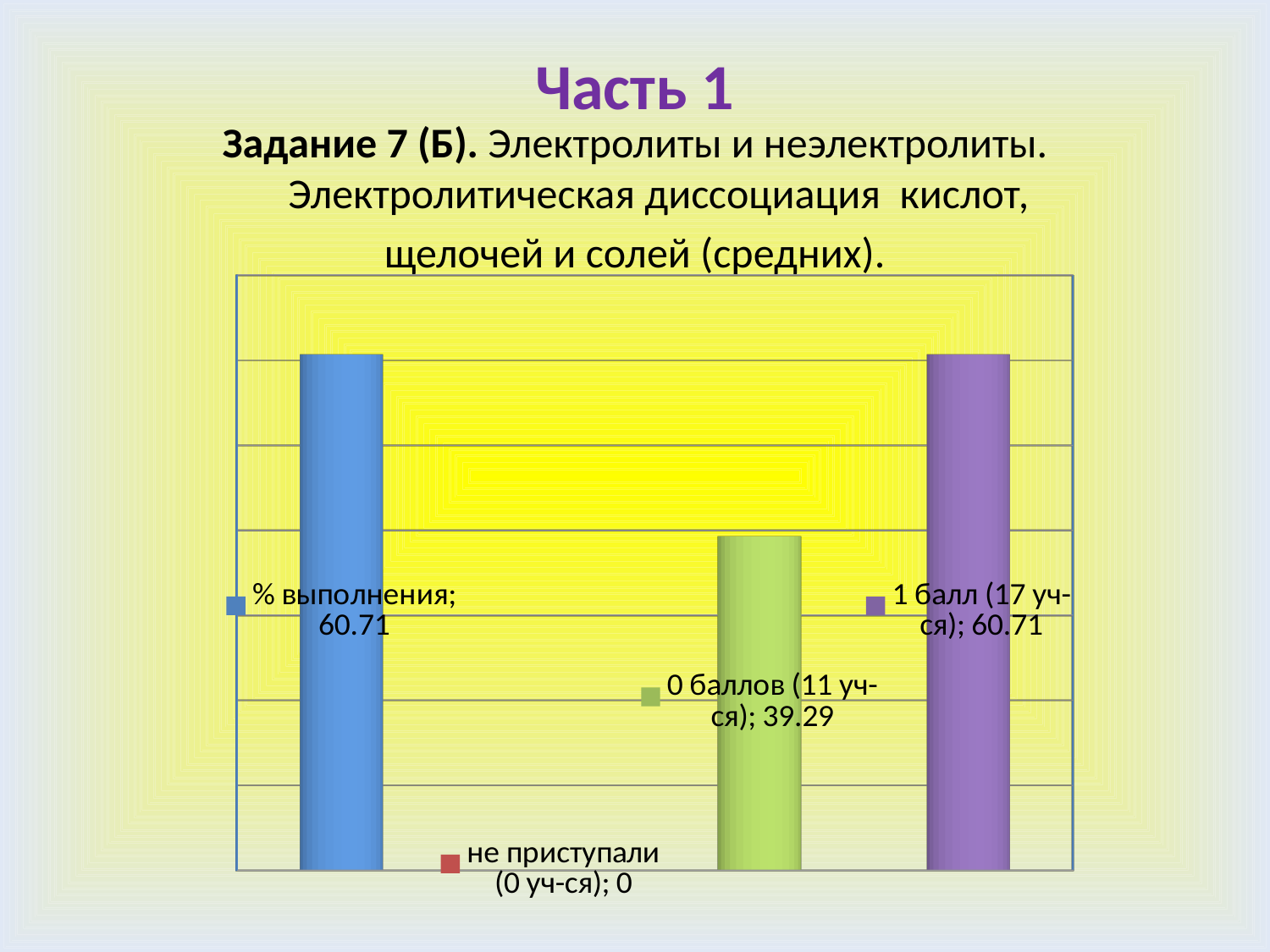
How many categories are plotted in the chart? 4 What is the value shown for "% выполнения"? 60.71 What is the value shown for "1 балл (17 уч-ся)"? 60.71 What is the value shown for "0 баллов (11 уч-ся)"? 39.29 How many students are indicated in the label for "0 баллов"? 11 What is the value shown for "не приступали (0 уч-ся)"? 0 What is the difference between the value for "% выполнения" and the value for "0 баллов (11 уч-ся)"? 21.42 What is the difference between the value for "1 балл (17 уч-ся)" and the value for "0 баллов (11 уч-ся)"? 21.42 Which category has the lowest value? не приступали (0 уч-ся) What is the heading at the top of the slide? Часть 1 Which is larger: the value for "0 баллов (11 уч-ся)" or the value for "1 балл (17 уч-ся)"? 1 балл (17 уч-ся) What kind of chart is shown on the slide? Bar chart